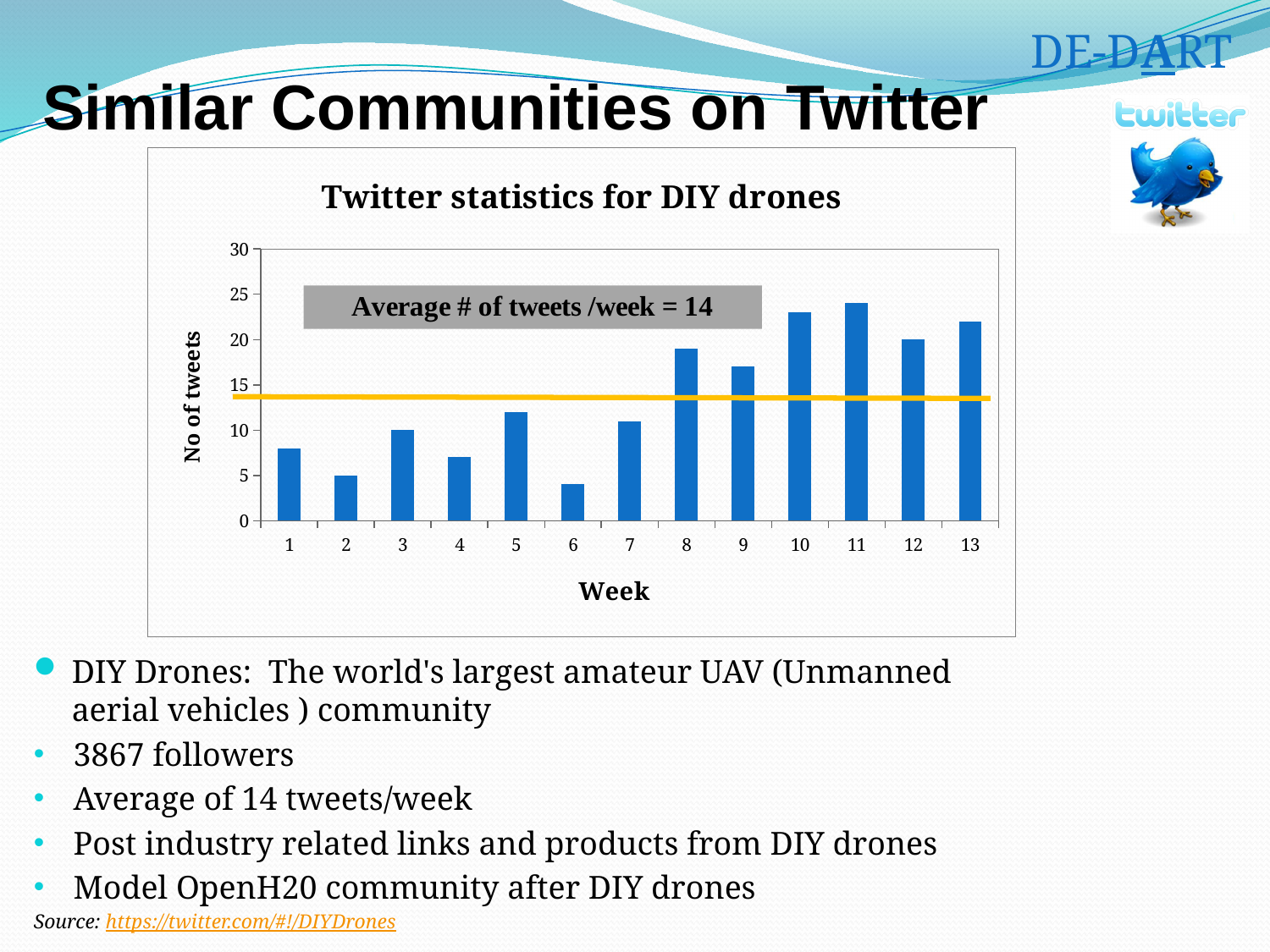
What average number of tweets per week does the chart's label state? 14 What is the number of tweets in week 2? 5 How many weeks are plotted on the x axis of the chart? 13 Which week has more tweets, week 10 or week 4? Week 10 What kind of chart is shown on the slide? Bar chart What is the title of the chart? Twitter statistics for DIY drones Is the value for week 1 greater or less than 10? less Is the value for week 6 greater or less than 5? less Is the value for week 8 greater or less than 15? greater Do the number of tweets generally rise or fall from week 1 to week 13? Rise What is the number of tweets in week 12? 20